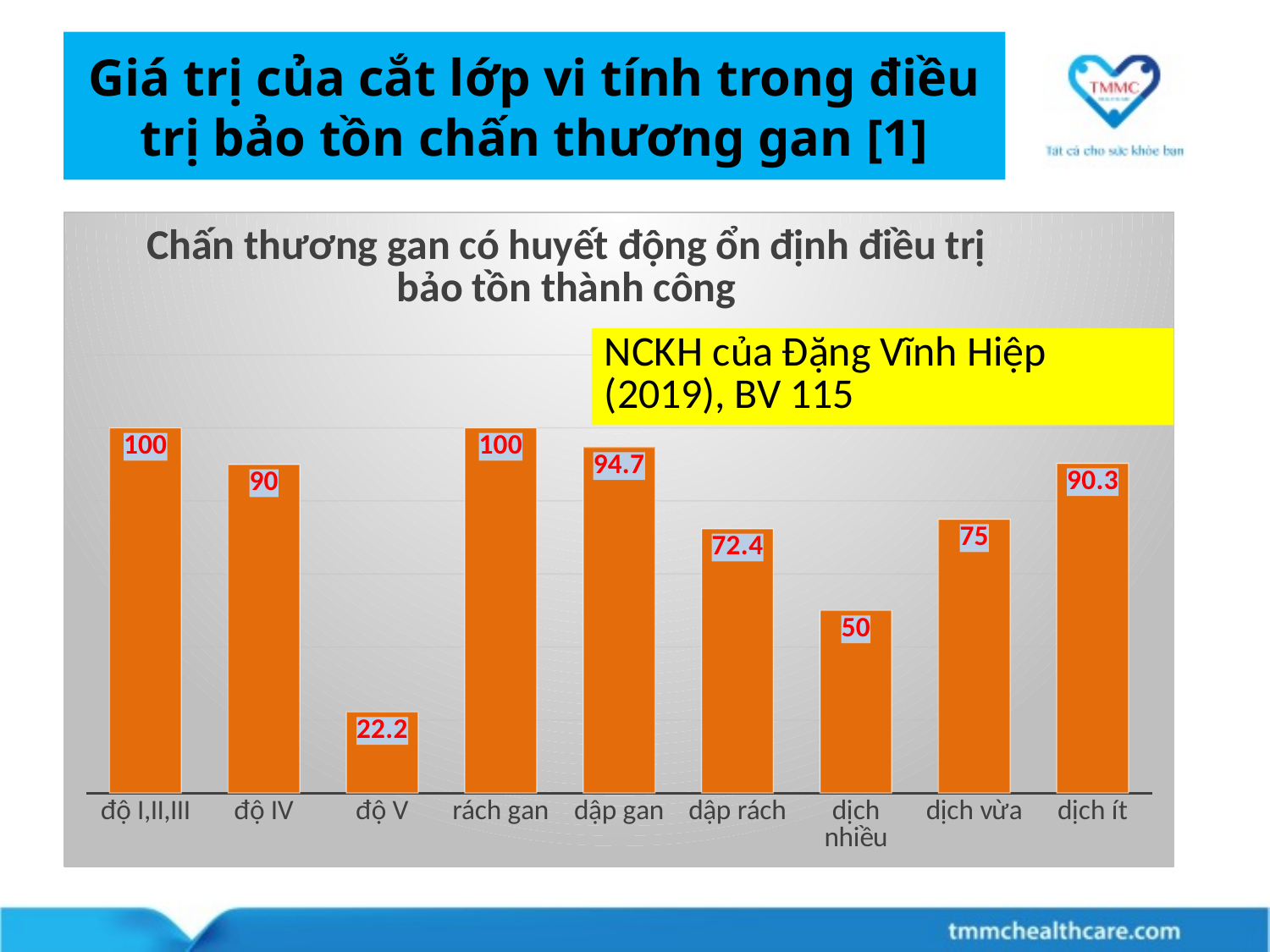
Which is larger, the value for dịch vừa or the value for dịch nhiều? dịch vừa What is the value for dịch nhiều? 50 What is the value for dập gan? 94.7 What is the value for độ V? 22.2 What is the difference between the values for độ IV and độ V? 67.8 What is the title of the chart? Chấn thương gan có huyết động ổn định điều trị bảo tồn thành công Which is larger, the value for độ IV or the value for dịch ít? dịch ít What is the difference between the values for dập gan and dập rách? 22.3 Which category has the lowest value? độ V What is the value for dịch ít? 90.3 How many categories are shown on the x axis? 9 What kind of chart is shown on the slide? bar chart